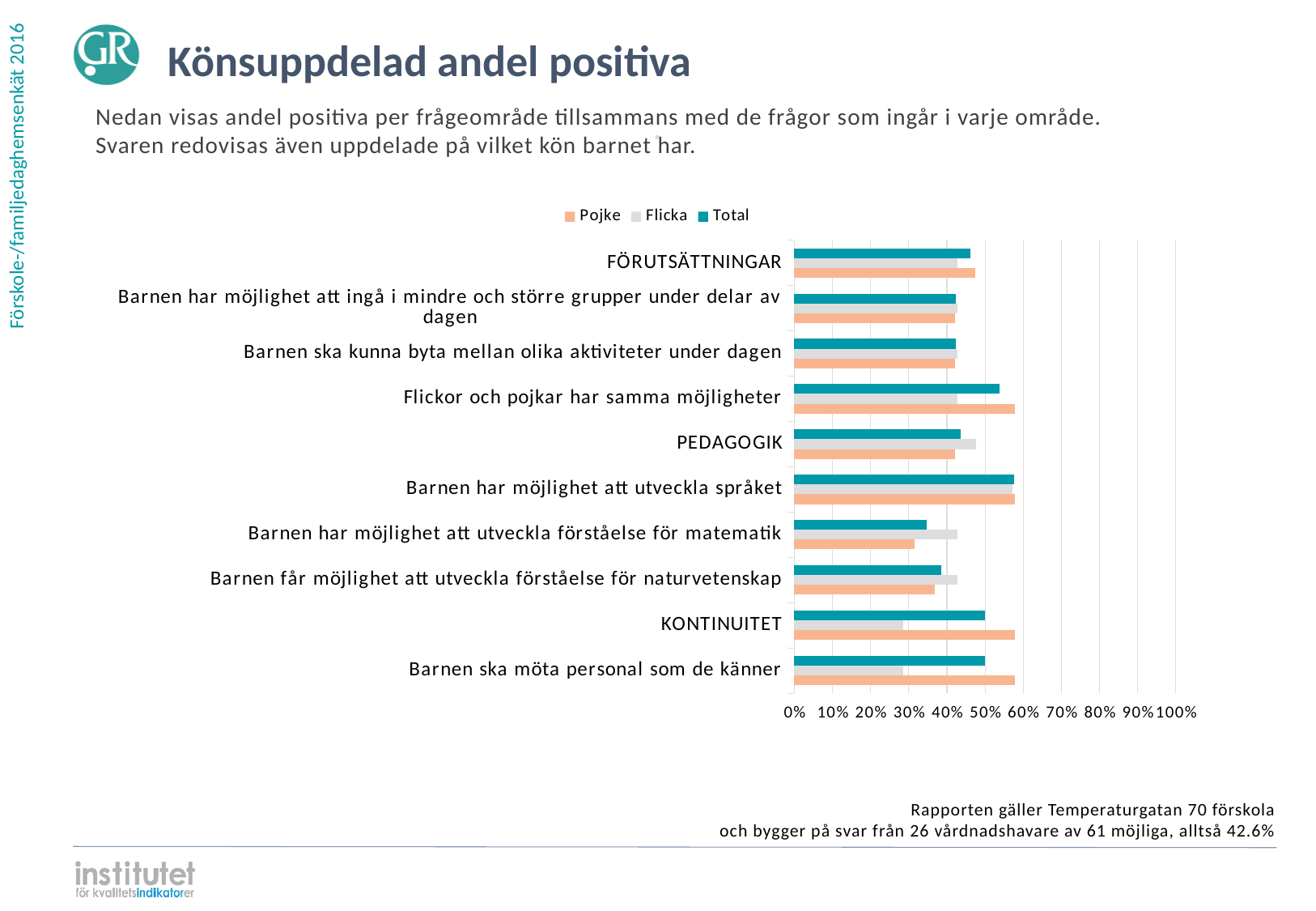
For KONTINUITET, which is larger: the Pojke value or the Flicka value? Pojke Is the Pojke value for KONTINUITET greater or less than 50%? greater Is the Pojke value for 'Barnen har möjlighet att utveckla förståelse för matematik' greater or less than 40%? less For 'Barnen har möjlighet att utveckla förståelse för matematik', which is larger: the Flicka value or the Pojke value? Flicka What kind of chart is shown on the slide? Bar chart How many series does the legend list? 3 How many categories are plotted on the chart? 10 What is the title of the chart slide? Könsuppdelad andel positiva Is the Total value for 'Barnen har möjlighet att utveckla språket' greater or less than 50%? greater For 'Flickor och pojkar har samma möjligheter', which is larger: the Pojke value or the Flicka value? Pojke What are the three series named in the legend? Pojke, Flicka, Total